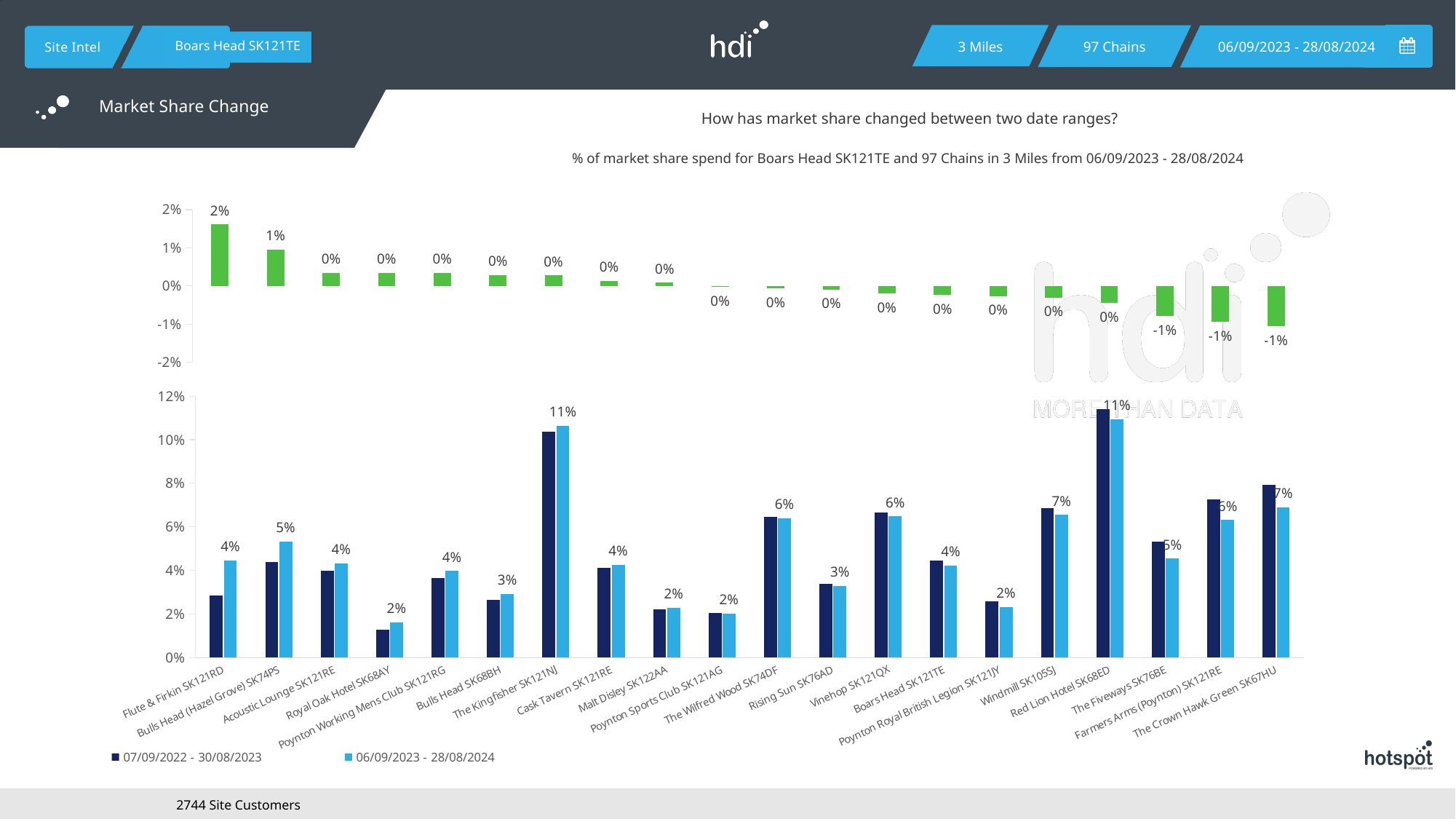
What are the two legend entries of the lower chart? 07/09/2022 - 30/08/2023 and 06/09/2023 - 28/08/2024 In the lower chart, is the 07/09/2022 - 30/08/2023 value for Royal Oak Hotel SK68AY greater or less than 2%? less In the lower chart, which has the larger 07/09/2022 - 30/08/2023 value: Red Lion Hotel SK68ED or Royal Oak Hotel SK68AY? Red Lion Hotel SK68ED In the upper (green) market share change chart, what is the value for The Crown Hawk Green SK67HU? -1% In the lower chart, what is the 06/09/2023 - 28/08/2024 value for The Kingfisher SK121NJ? 11% In the upper (green) market share change chart, what is the value for Flute & Firkin SK121RD? 2% In the lower chart, how many series does the legend list? 2 In the lower chart, is the 07/09/2022 - 30/08/2023 value for The Kingfisher SK121NJ greater or less than 10%? greater In the upper (green) market share change chart, which category has the highest value? Flute & Firkin SK121RD What kind of chart is the lower chart on the slide? bar chart How many categories are shown on the x axis of the lower chart? 20 In the lower chart, what is the 06/09/2023 - 28/08/2024 value for Bulls Head (Hazel Grove) SK74PS? 5%